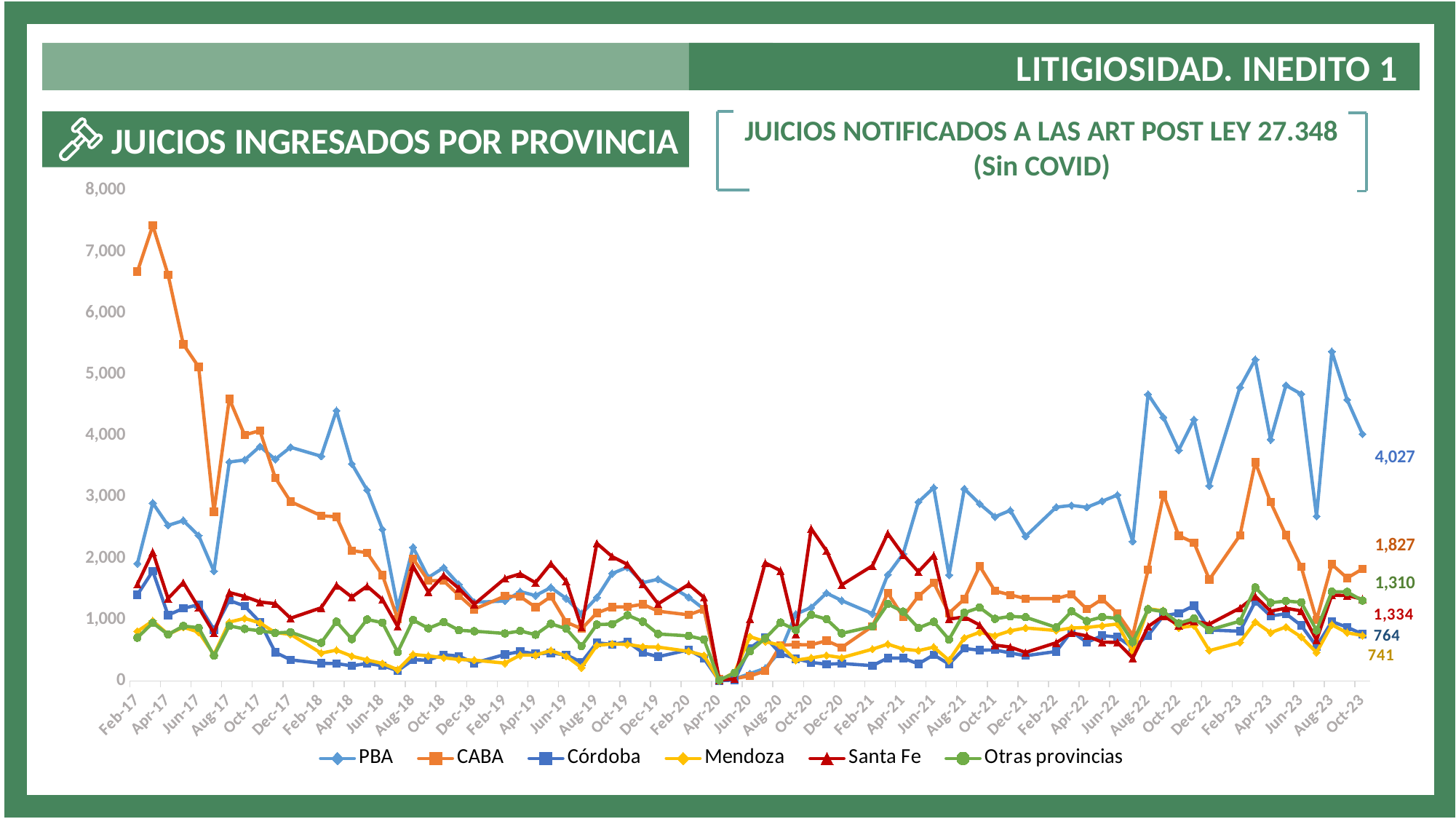
What is the difference between the PBA and CABA values at Oct-23? 2,200 Is the value for CABA in Apr-17 greater or less than 7,000? less What is the title of the chart? JUICIOS INGRESADOS POR PROVINCIA What is the value for CABA at Oct-23? 1,827 Which series has the highest value at Oct-23? PBA What is the value for Santa Fe at Oct-23? 1,334 What is the value for Mendoza at Oct-23? 741 What is the value for PBA at Oct-23? 4,027 Does the CABA series rise or fall between Feb-17 and Feb-18? fall At Oct-23, which is larger: Córdoba or Mendoza? Córdoba What type of chart is shown on the slide? line chart How many series does the legend list? 6